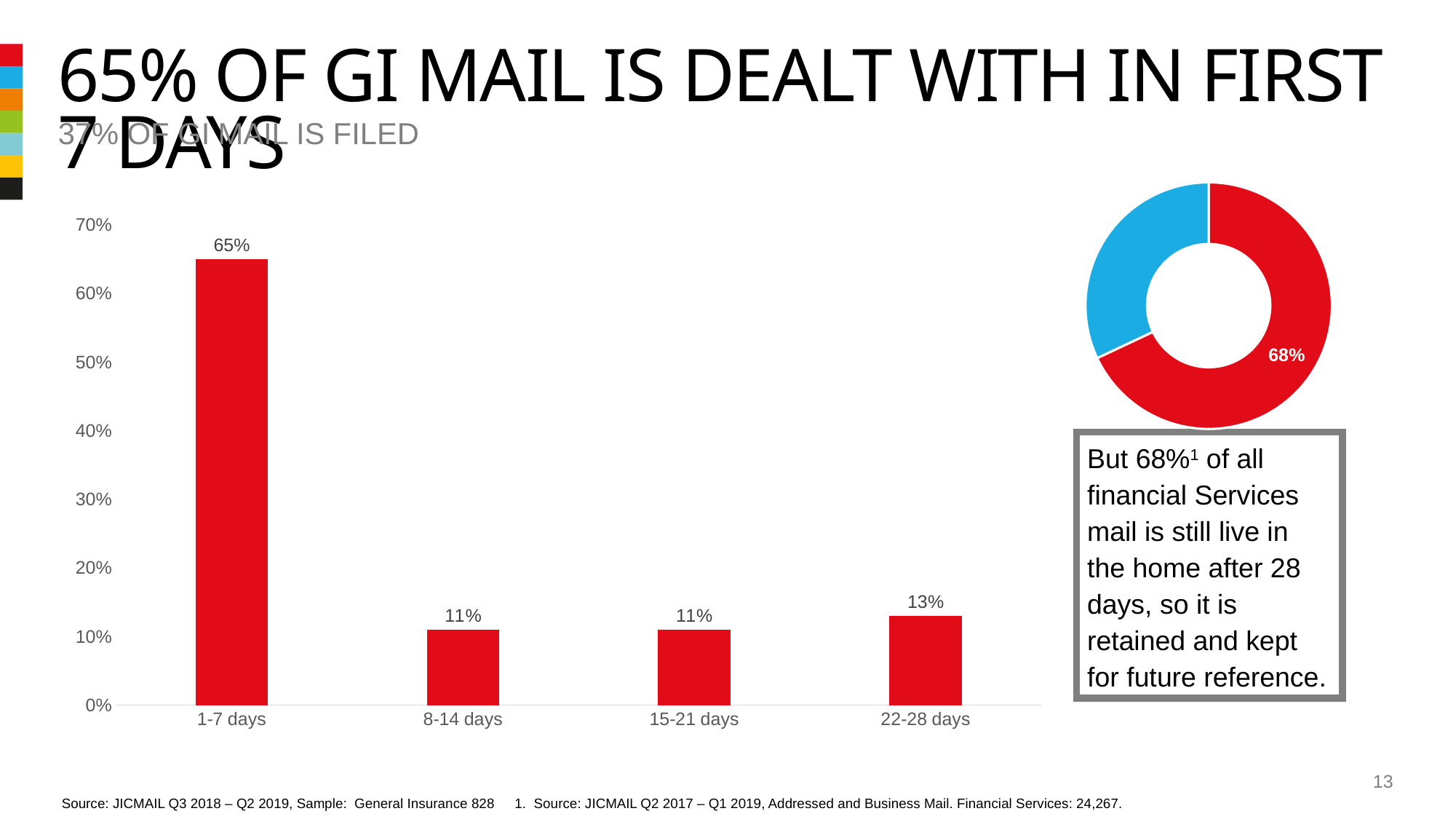
In the bar chart on the left, which is larger, the value for 1-7 days or the value for 8-14 days? 1-7 days In the bar chart on the left, what is the difference between the values for 1-7 days and 22-28 days? 52% What kind of chart is shown on the left of the slide? bar chart In the bar chart on the left, what is the value for 8-14 days? 11% In the bar chart on the left, what is the value for 1-7 days? 65% What kind of chart is shown on the right of the slide? donut chart In the bar chart on the left, what is the value for 22-28 days? 13% In the donut chart on the right, what value is printed on the red segment? 68% How many categories are shown in the bar chart on the left? 4 In the bar chart on the left, what is the difference between the values for 22-28 days and 15-21 days? 2% In the bar chart on the left, is the value for 1-7 days greater or less than 60%? greater In the bar chart on the left, which category has the highest value? 1-7 days